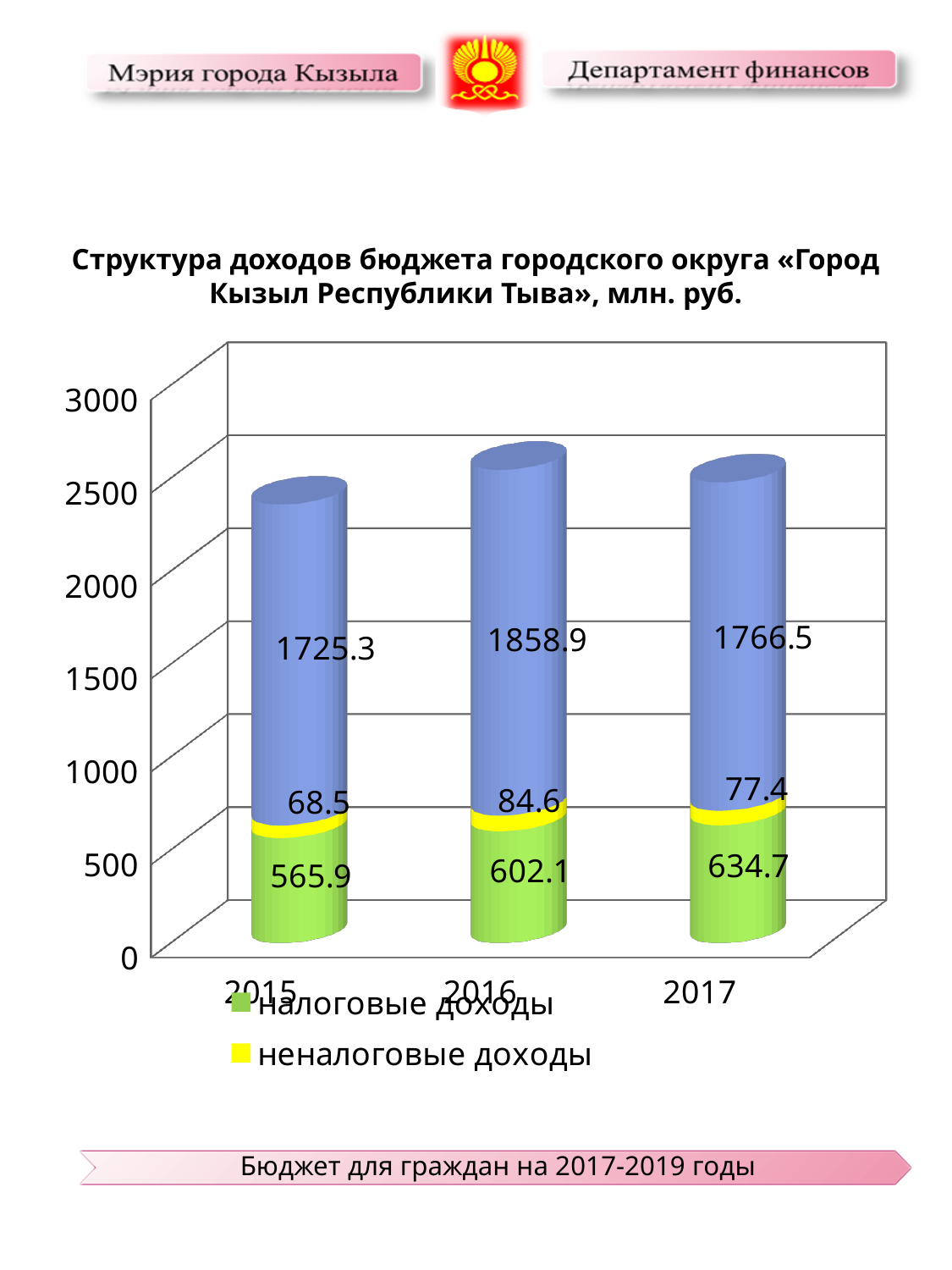
By how much do налоговые доходы in 2017 exceed those in 2015? 68.8 What is the value of неналоговые доходы for 2016? 84.6 In which year are неналоговые доходы the lowest? 2015 Do налоговые доходы rise or fall from 2015 to 2017? Rise What is the total of the stacked bar for 2016? 2545.6 What kind of chart is shown on the slide? Stacked bar chart What is the value of налоговые доходы for 2017? 634.7 Which year has larger налоговые доходы, 2015 or 2016? 2016 In which year are налоговые доходы the highest? 2017 What is the difference between неналоговые доходы in 2016 and in 2017? 7.2 What is the value of налоговые доходы for 2015? 565.9 How many years are shown on the x axis of the chart? 3